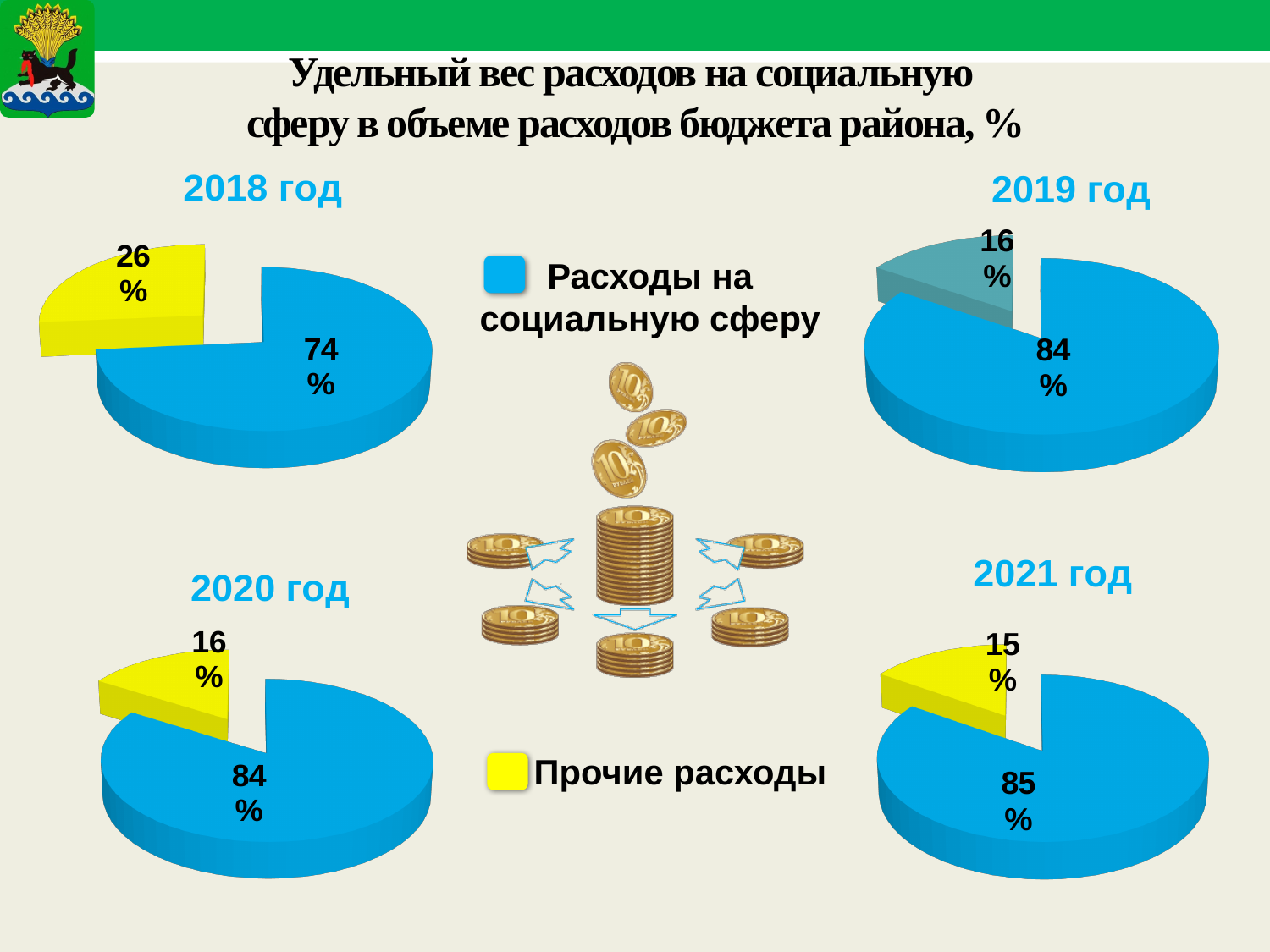
Across the four pie charts, which year has the largest share for Расходы на социальную сферу? 2021 год Across the four pie charts, which year has the smallest share for Расходы на социальную сферу? 2018 год How many slices does the 2021 год pie chart have? 2 Which colour represents Прочие расходы in the legend? Yellow In the 2018 год pie chart, what share is labelled for Прочие расходы? 26% In the 2018 год pie chart, what share is labelled for Расходы на социальную сферу (the blue slice)? 74% In the 2019 год pie chart, what share is labelled for the blue slice (Расходы на социальную сферу)? 84% What is the difference between the Расходы на социальную сферу share in 2021 год and in 2018 год? 11% How many pie charts are shown on the slide? 4 What kind of chart is used for each year on this slide? Pie chart In the 2020 год pie chart, what share is labelled for the blue slice? 84% In the 2021 год pie chart, what share is labelled for Прочие расходы (the yellow slice)? 15%